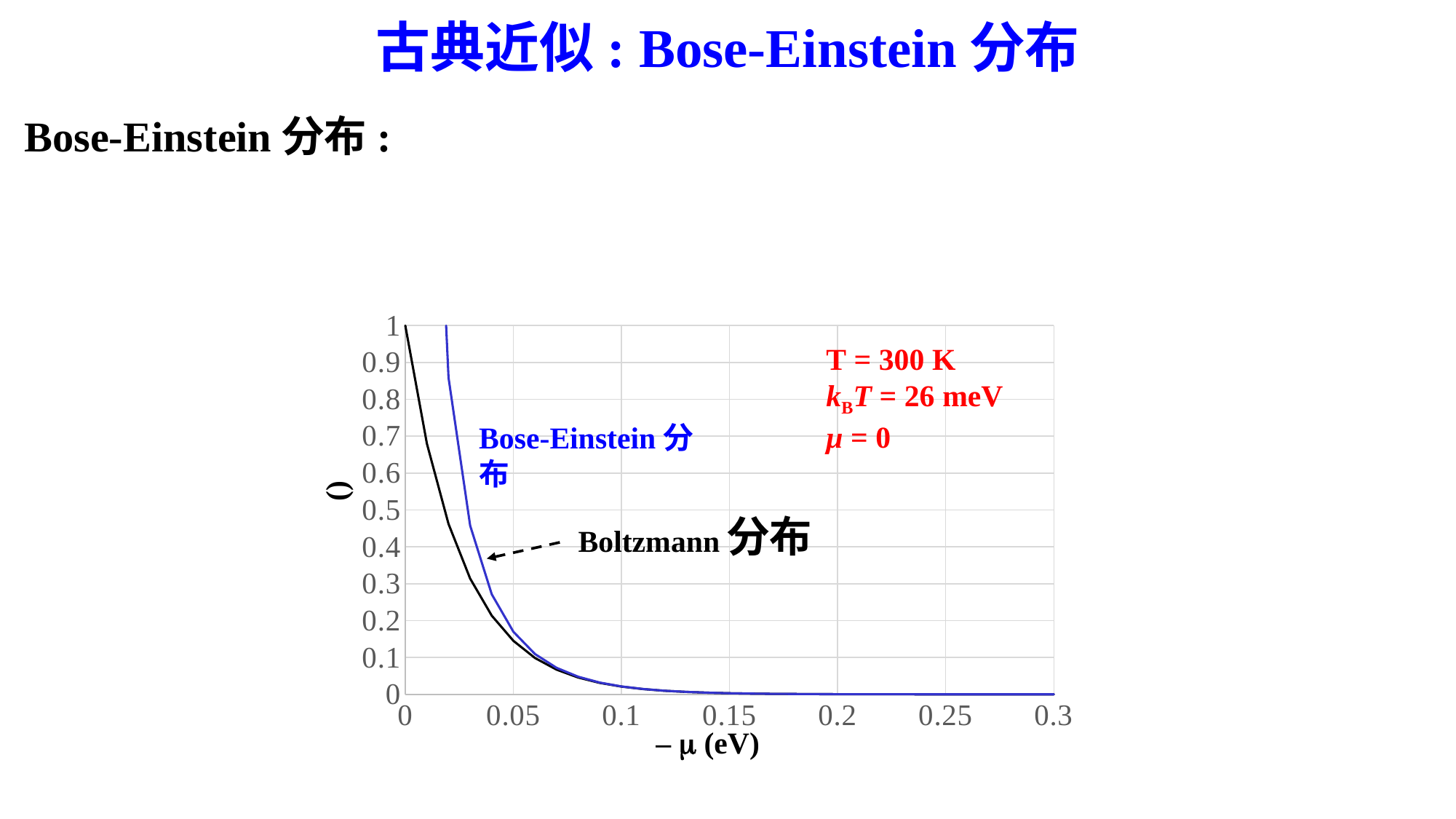
What temperature T is stated in the annotation on the chart? T = 300 K At −μ = 0.03 eV, which curve is higher, the Bose-Einstein distribution or the Boltzmann distribution? Bose-Einstein distribution As −μ increases along the x axis, do the plotted distribution values rise or fall? fall How many tick labels are shown on the x axis of the chart? 7 Is the value of the Boltzmann distribution at −μ = 0.1 eV greater or less than 0.2? less Is the value of the Boltzmann distribution at −μ = 0.2 eV greater or less than 0.1? less What is the value of the Boltzmann distribution at −μ = 0? 1 How many curves (distributions) are plotted on the chart? 2 What kind of chart is shown on the slide? line chart What is the label of the x axis of the chart? − μ (eV) Is the value of the Bose-Einstein distribution at −μ = 0.05 eV greater or less than 0.3? less